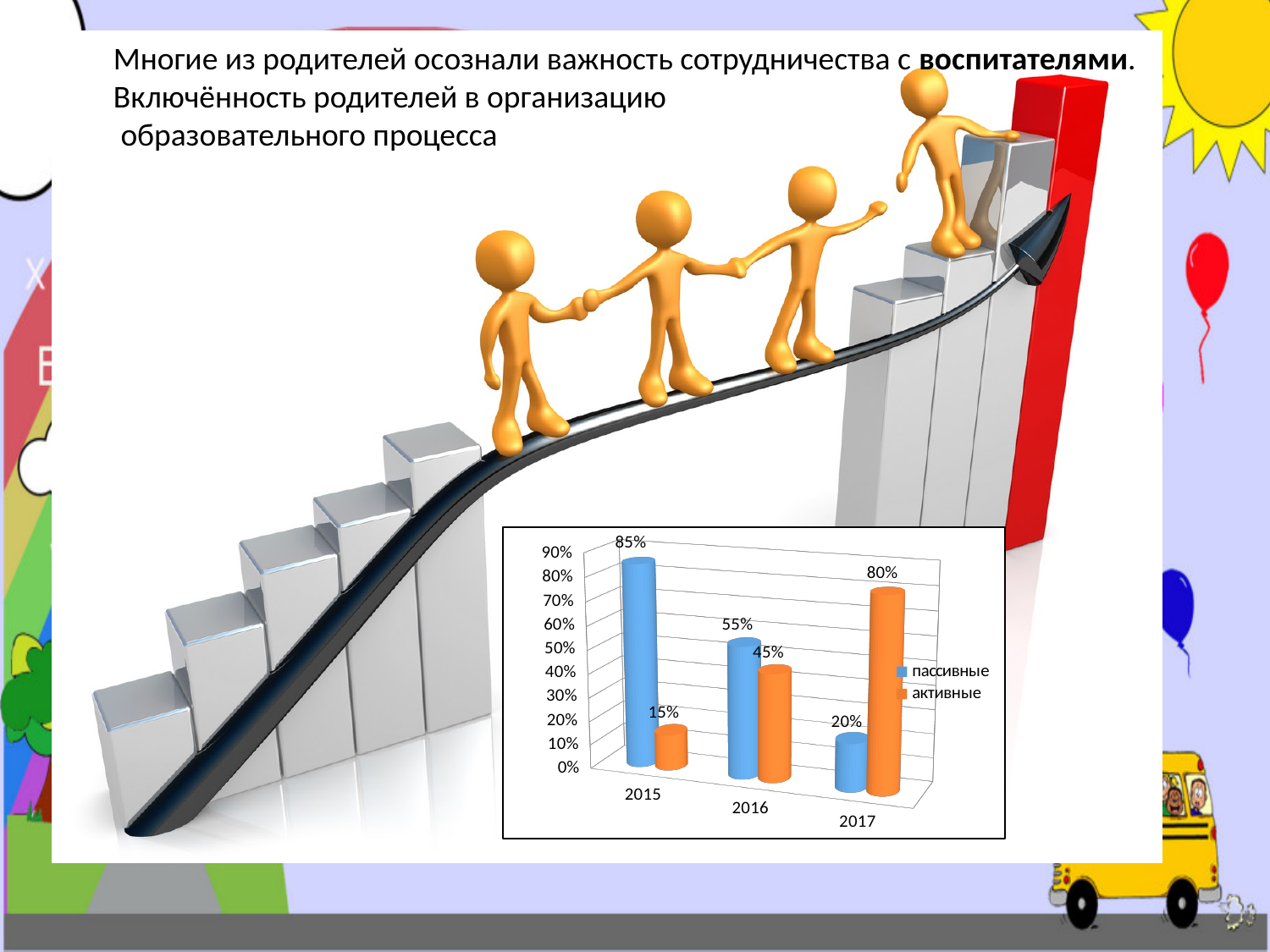
What is the value for пассивные in 2015? 85% What is the value for активные in 2017? 80% What is the difference between пассивные and активные in 2015? 70% In which year is the value for пассивные the lowest? 2017 In which year is the value for активные the highest? 2017 What kind of chart is shown on the slide? bar chart Which series is shown in orange in the chart? активные Which is larger in 2016, пассивные or активные? пассивные How many series does the chart legend list? 2 What is the value for активные in 2016? 45% Do the values for активные rise or fall from 2015 to 2017? rise How many years are shown on the x axis of the chart? 3